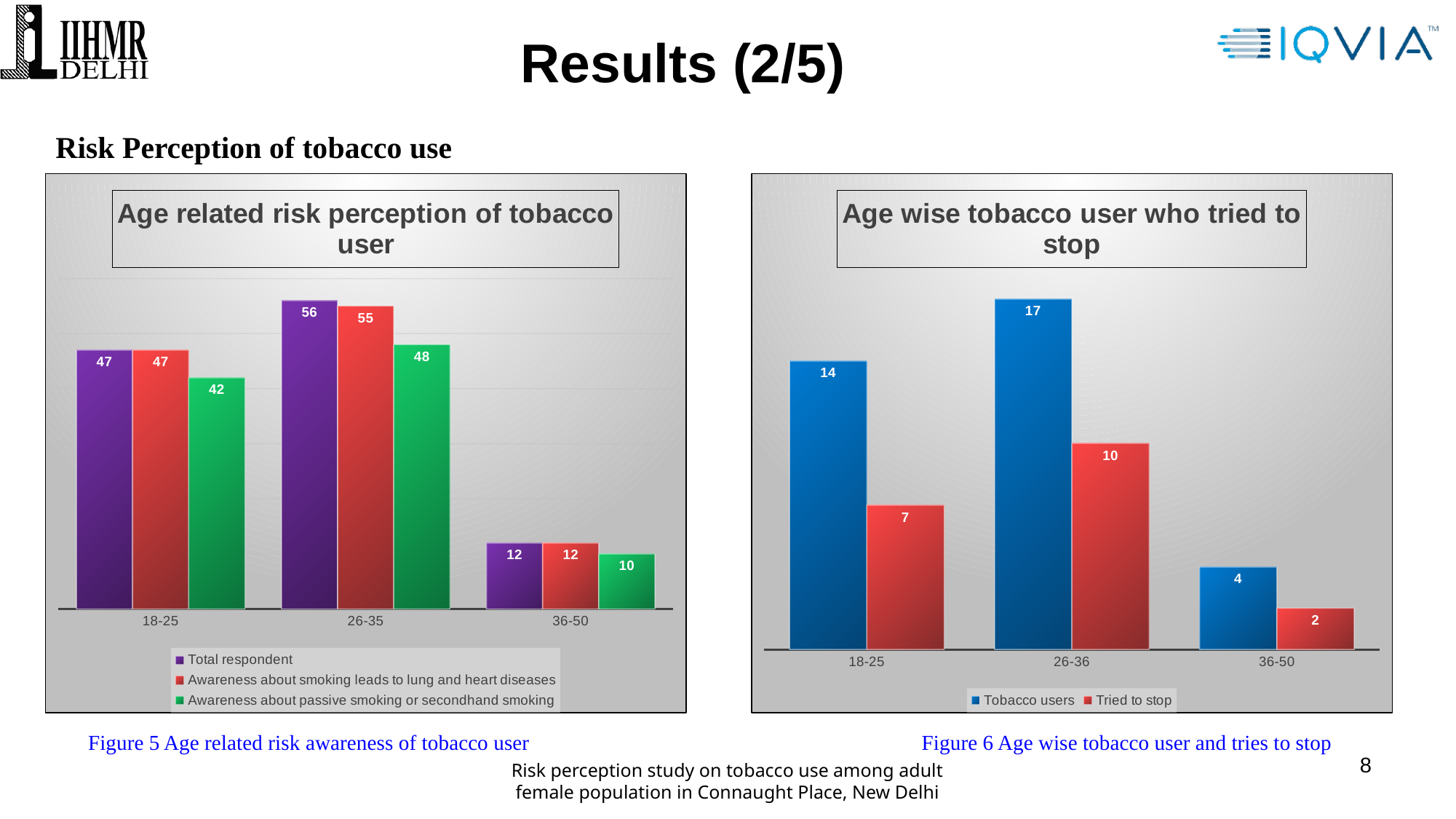
In the 'Age related risk perception of tobacco user' chart, how many series does the legend list? 3 In the 'Age wise tobacco user who tried to stop' chart, what is the value for Tried to stop in the 26-36 age group? 10 What kind of chart is the 'Age wise tobacco user who tried to stop' chart? Bar chart In the 'Age wise tobacco user who tried to stop' chart, what colour are the Tobacco users bars? Blue In the 'Age related risk perception of tobacco user' chart, how many age groups are shown on the x axis? 3 In the 'Age wise tobacco user who tried to stop' chart, which is larger: Tried to stop for 18-25 or Tried to stop for 36-50? 18-25 In the 'Age wise tobacco user who tried to stop' chart, which age group has the highest number of Tobacco users? 26-36 In the 'Age related risk perception of tobacco user' chart, which age group has the lowest value for Total respondent? 36-50 In the 'Age wise tobacco user who tried to stop' chart, what is the difference between Tobacco users and Tried to stop in the 18-25 age group? 7 In the 'Age related risk perception of tobacco user' chart, what is the value for Awareness about passive smoking or secondhand smoking in the 18-25 age group? 42 In the 'Age related risk perception of tobacco user' chart, what is the difference between Total respondent and Awareness about passive smoking or secondhand smoking in the 26-35 age group? 8 In the 'Age related risk perception of tobacco user' chart, what is the value for Total respondent in the 26-35 age group? 56